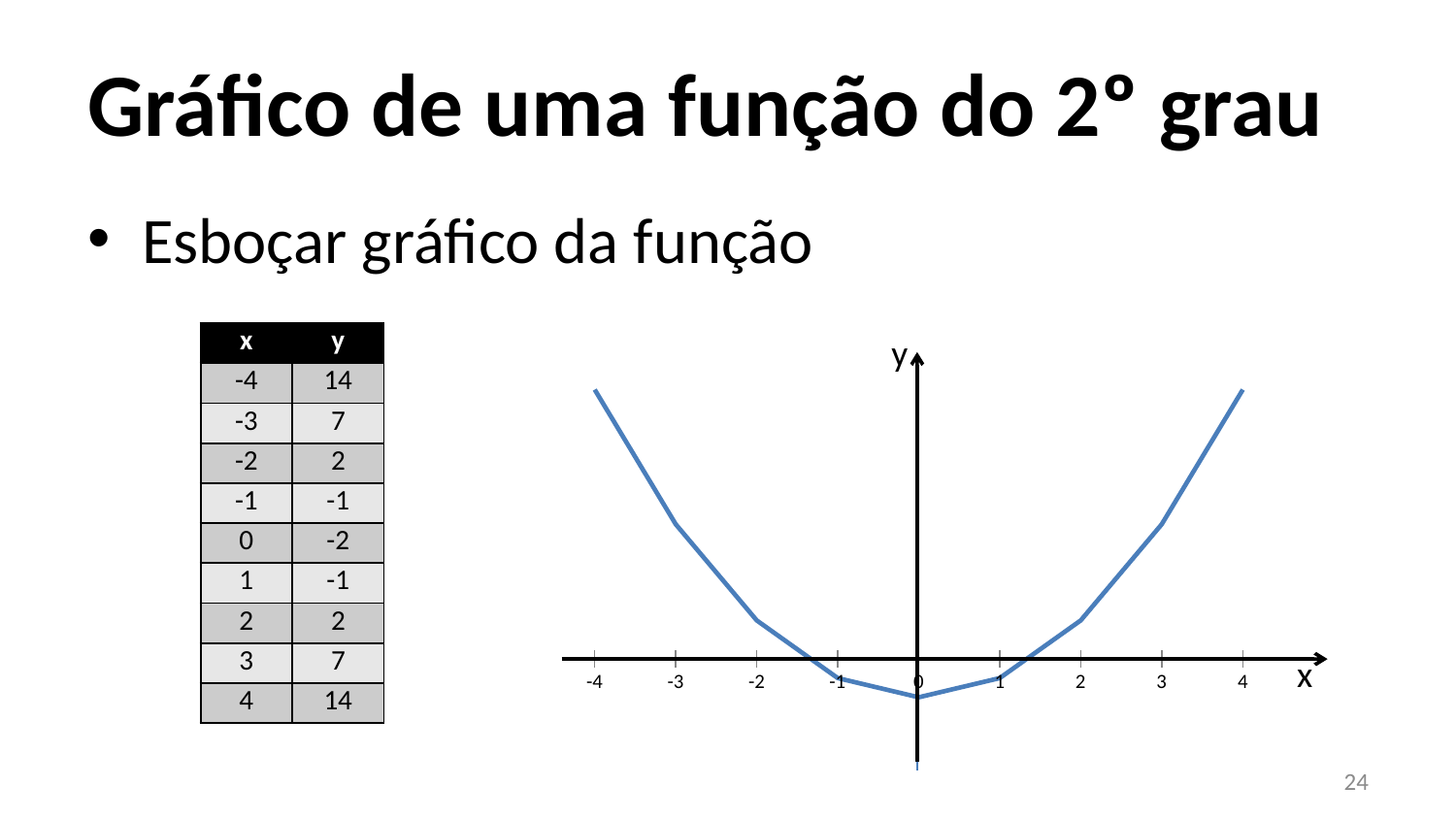
What kind of chart is shown on the slide? line chart What is the lowest y value plotted on the curve? -2 According to the table on the slide, what is the value of y when x = 0? -2 Which is larger: the y value at x = -3 or the y value at x = -2? x = -3 Does the curve rise or fall as x goes from 0 to 4? rise What is the difference between the y value at x = 4 and the y value at x = 3? 7 What is the label on the horizontal axis of the chart? x What is the highest y value plotted on the curve? 14 According to the table on the slide, what is the value of y when x = -3? 7 How many data points are plotted on the curve (one for each x value in the table)? 9 According to the table on the slide, what is the value of y when x = 4? 14 At which value of x does the curve reach its lowest point? 0